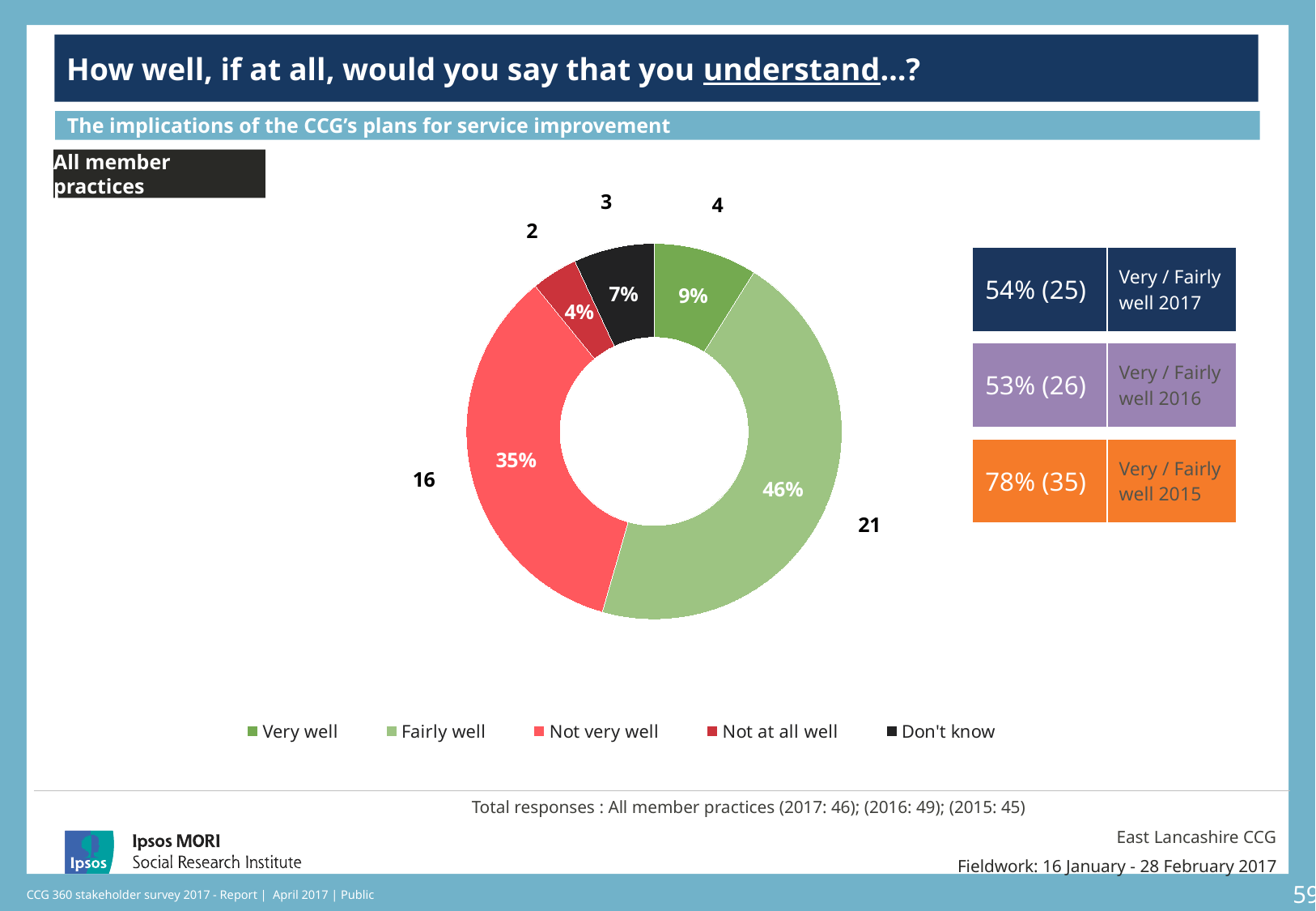
What is the difference in percentage points between 'Fairly well' and 'Not very well'? 11 What type of chart is used to show the responses? Donut chart What percentage of respondents answered 'Not very well'? 35% What is the combined percentage for 'Very well' and 'Fairly well' in 2017, as shown in the box to the right of the chart? 54% (25) What colour represents 'Not very well' in the chart? Red How many respondents answered 'Very well'? 4 How many response categories are shown in the donut chart? 5 Which response category has the smallest share of the donut chart? Not at all well Which response category has the largest share of the donut chart? Fairly well What percentage of respondents answered 'Don't know'? 7% Which is larger, the share for 'Very well' or the share for 'Don't know'? Very well What percentage of respondents said they understand the implications of the CCG's plans for service improvement 'Fairly well'? 46%